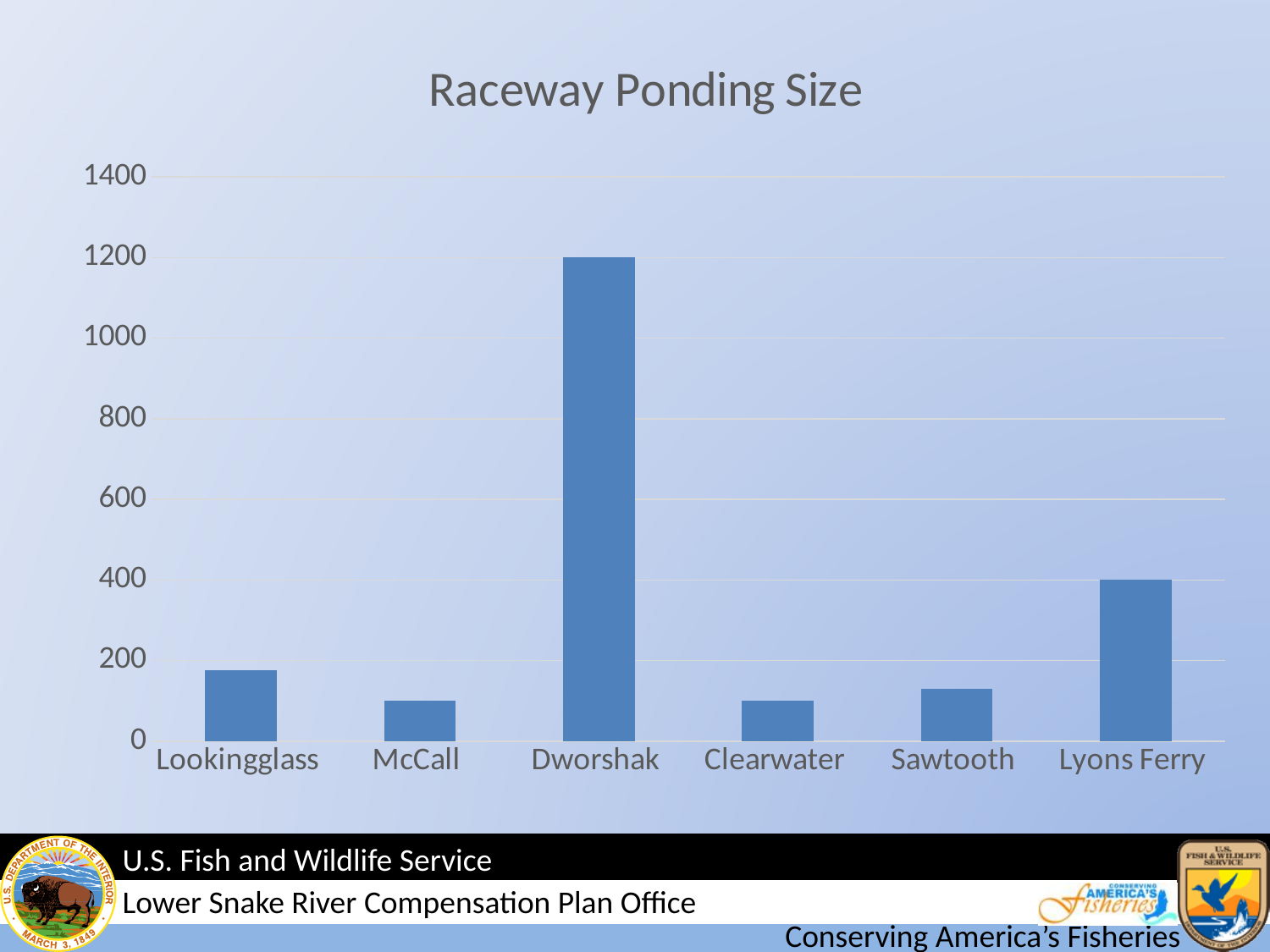
What type of chart is shown on the slide? bar chart Which is larger, the value for Lyons Ferry or the value for Clearwater? Lyons Ferry Is the value for Lookingglass greater or less than 200? less How many categories are shown on the x axis of the chart? 6 Which is larger, the value for Lookingglass or the value for Sawtooth? Lookingglass Is the value for Dworshak greater or less than 1000? greater Which category has the highest value in the chart? Dworshak What is the difference between the values for Dworshak and Lyons Ferry? 800 Is the value for Sawtooth greater or less than 200? less What is the value for Dworshak? 1200 What is the value for Lyons Ferry? 400 What is the title of the chart? Raceway Ponding Size